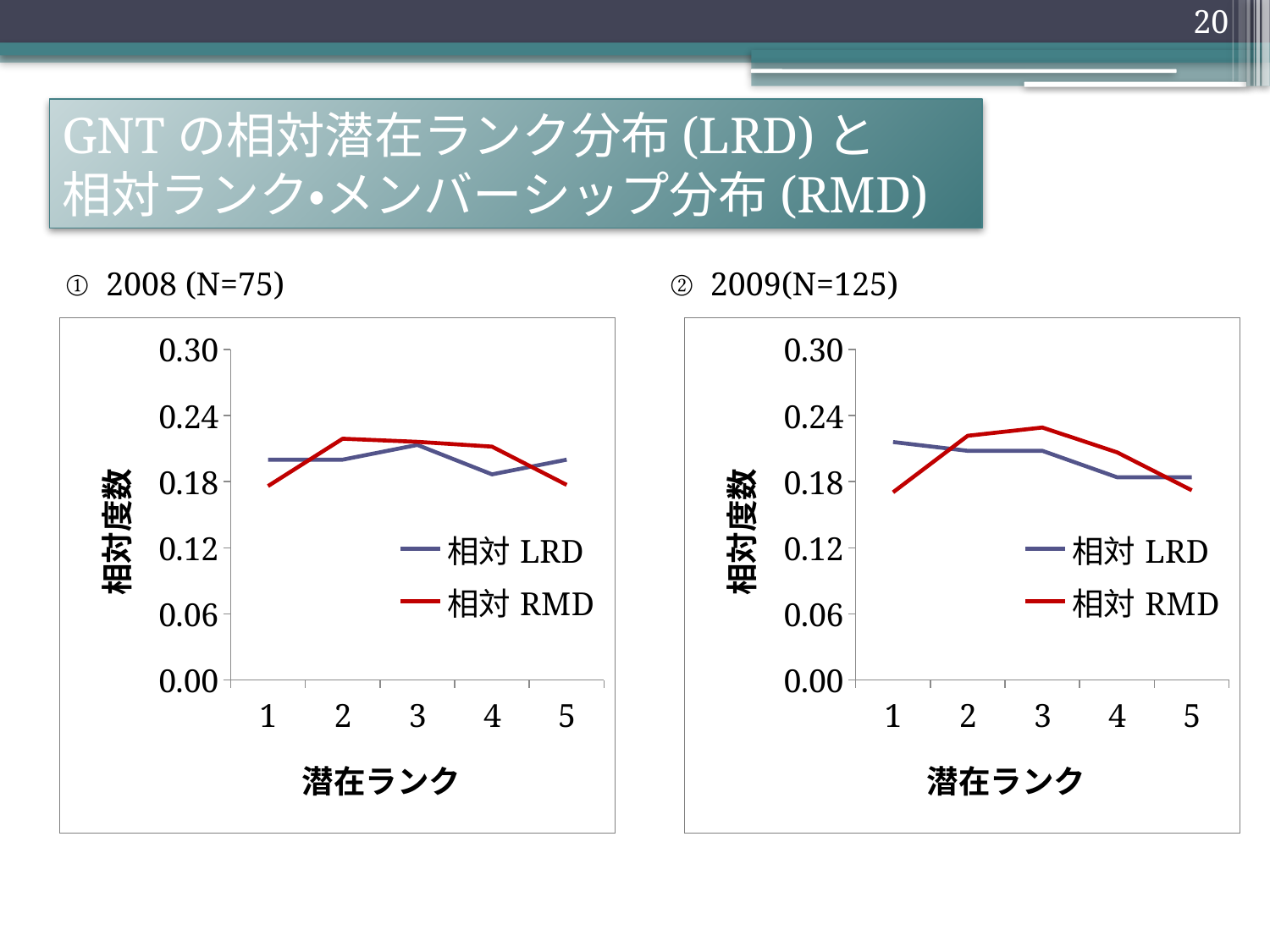
How many 潜在ランク categories are shown on the x axis of the 2008 (N=75) chart? 5 What type of chart is the 2008 (N=75) chart on the left? line chart In the 2009 (N=125) chart, is the value of 相対 RMD at 潜在ランク 5 greater or less than 0.18? less In the 2009 (N=125) chart, is the value of 相対 RMD at 潜在ランク 3 greater or less than 0.18? greater In the 2009 (N=125) chart, at which 潜在ランク does 相対 RMD reach its highest value? 3 In the 2009 (N=125) chart, which series has the larger value at 潜在ランク 3, 相対 LRD or 相対 RMD? 相対 RMD In the 2008 (N=75) chart, is the value of 相対 RMD at 潜在ランク 2 greater or less than 0.18? greater In the 2009 (N=125) chart, does 相対 RMD rise or fall from 潜在ランク 3 to 潜在ランク 5? fall In the 2009 (N=125) chart, which series has the larger value at 潜在ランク 1, 相対 LRD or 相対 RMD? 相対 LRD How many series does the legend of the 2009 (N=125) chart on the right list? 2 What is the label of the y axis on the 2008 (N=75) chart? 相対度数